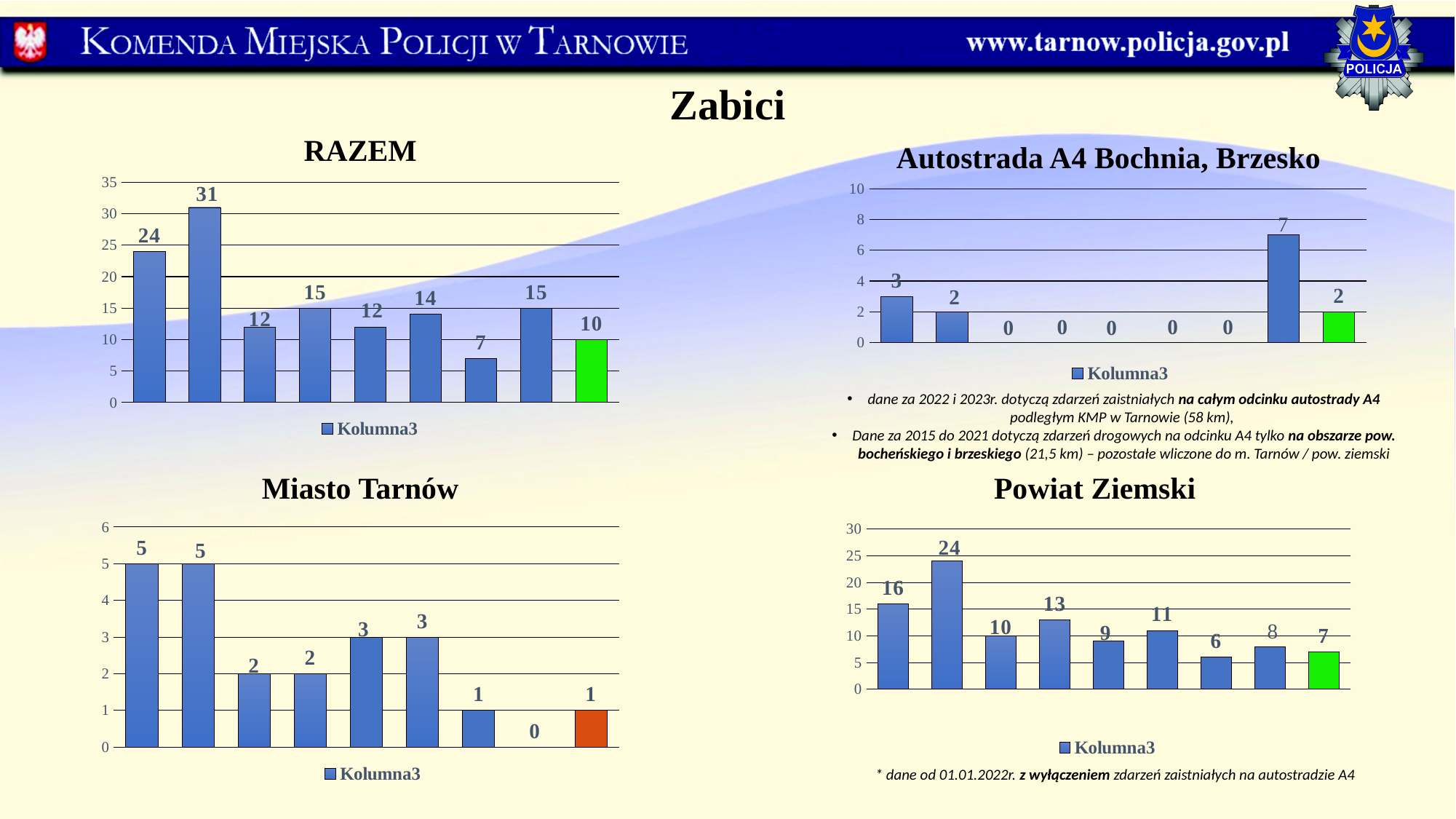
In the RAZEM chart, what is the difference between the highest bar and the first bar? 7 In the Autostrada A4 Bochnia, Brzesko chart, how many bars have a value of 0? 5 In the Miasto Tarnów chart, what is the highest value shown? 5 In the RAZEM chart, what is the lowest value shown? 7 In the RAZEM chart, what is the highest value shown? 31 In the Miasto Tarnów chart, what is the value of the last (orange) bar? 1 In the Powiat Ziemski chart, is the first bar or the last (green) bar larger? the first bar In the Powiat Ziemski chart, what is the highest value shown? 24 In the RAZEM chart, what is the value of the last (green) bar? 10 How many bars are plotted in the RAZEM chart? 9 What type of chart is the Powiat Ziemski chart? bar chart